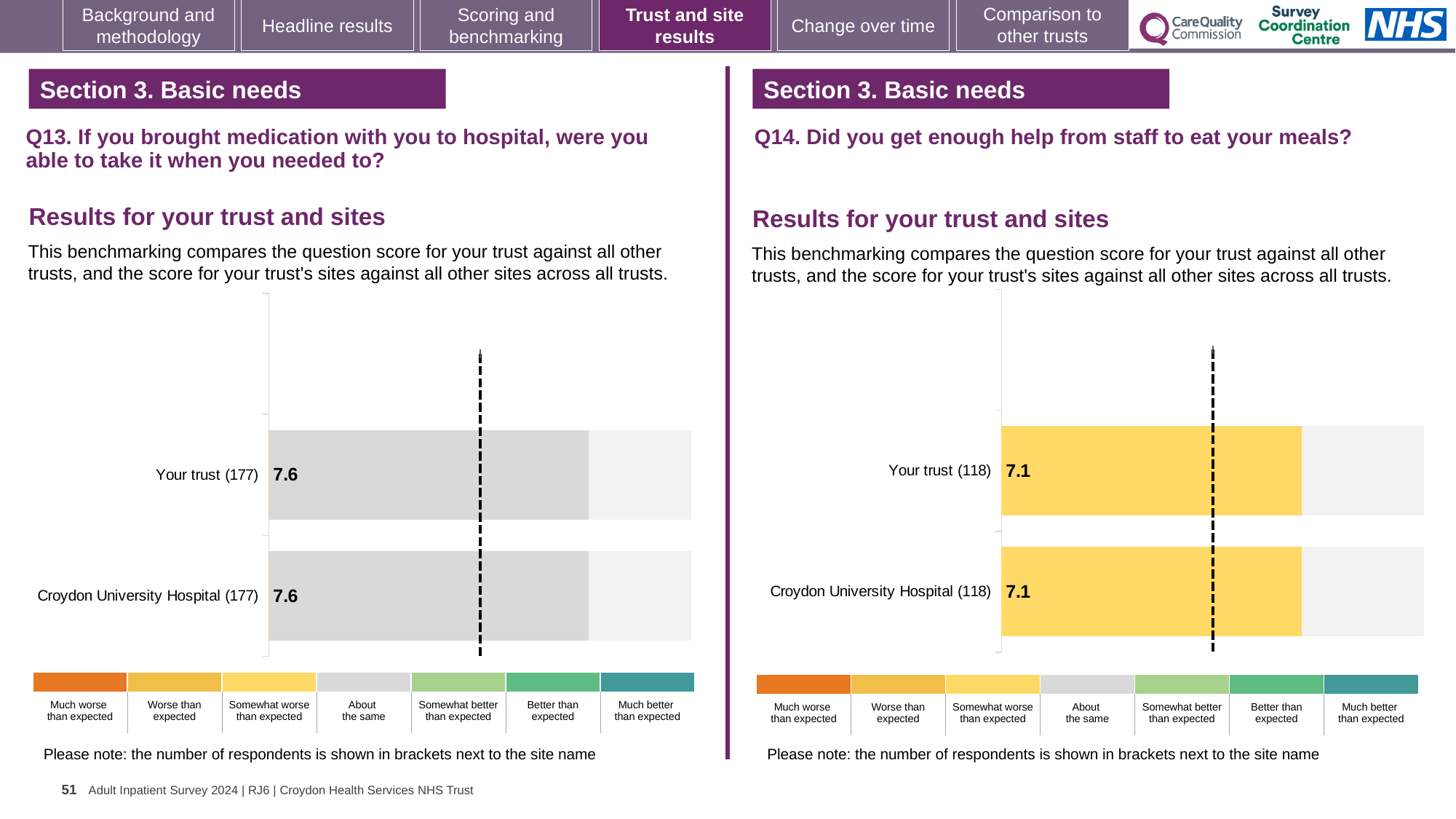
On the Q14 chart (right), what is the score for Your trust? 7.1 How many bars are plotted on the Q13 chart (left)? 2 How many bars are plotted on the Q14 chart (right)? 2 Is the score for Your trust on the Q13 chart (left) larger or smaller than the score for Your trust on the Q14 chart (right)? Larger On the Q13 chart (left), what is the score for Your trust? 7.6 What kind of chart is used on the Q13 chart (left)? Bar chart On the Q13 chart (left), what is the difference between the score for Your trust and the score for Croydon University Hospital? 0 On the Q14 chart (right), how many respondents are shown in brackets for Croydon University Hospital? 118 On the Q13 chart (left), how many respondents are shown in brackets for Your trust? 177 On the Q14 chart (right), what is the difference between the score for Your trust and the score for Croydon University Hospital? 0 On the Q13 chart (left), what is the score for Croydon University Hospital? 7.6 On the Q14 chart (right), what is the score for Croydon University Hospital? 7.1